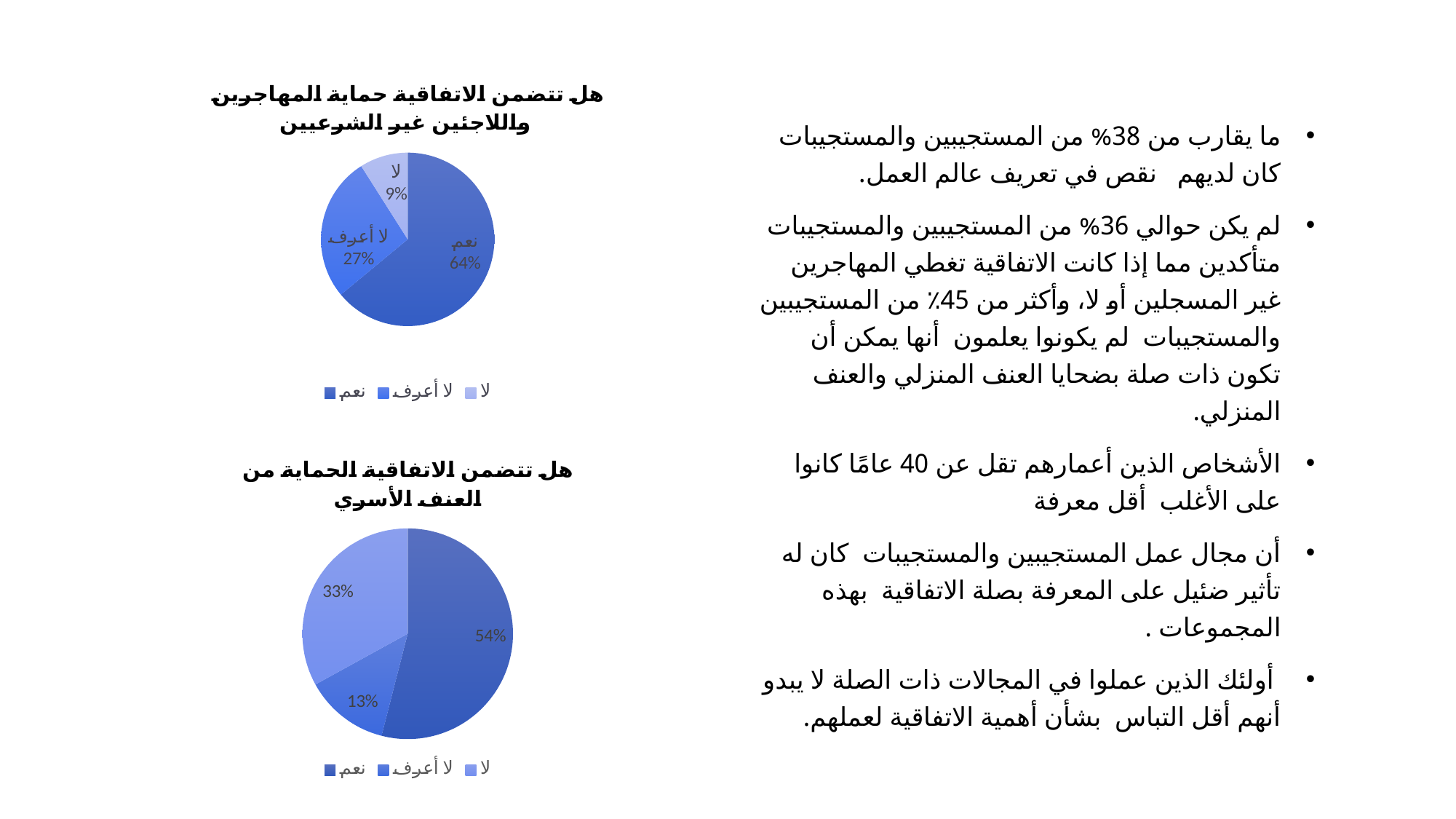
How many entries does the legend of the top chart list? 3 In the top pie chart, what percentage is shown for لا أعرف? 27% In the top pie chart (هل تتضمن الاتفاقية حماية المهاجرين واللاجئين غير الشرعيين), what percentage is shown for نعم? 64% In the bottom pie chart, what is the smallest percentage shown? 13% What type of chart is the top chart on the slide? Pie chart In the top pie chart, which category has the smallest share? لا In the top pie chart, what percentage is shown for لا? 9% How many slices does the bottom pie chart have? 3 In the bottom pie chart (هل تتضمن الاتفاقية الحماية من العنف الأسري), what is the largest percentage shown? 54% In the top pie chart, which category has the largest share? نعم In the top pie chart, what is the difference between the نعم share and the لا أعرف share? 37% In the bottom pie chart, what is the difference between the 54% slice and the 33% slice? 21%